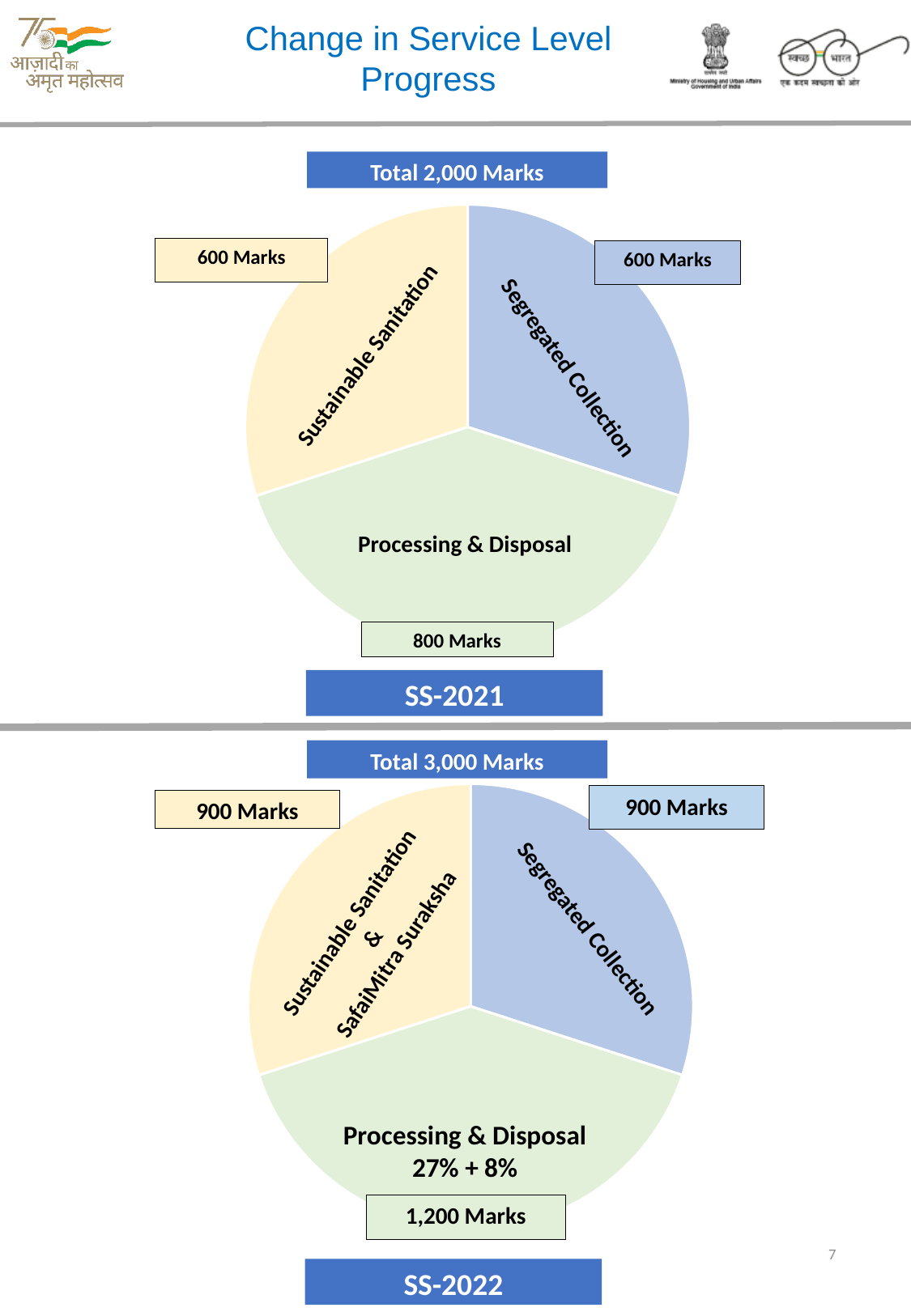
In the SS-2022 chart (bottom), what is the difference in marks between Processing & Disposal and Sustainable Sanitation & SafaiMitra Suraksha? 300 Marks In the SS-2022 chart (bottom), how many marks are allotted to Segregated Collection? 900 Marks How many categories does the SS-2021 chart (top) show? 3 In the SS-2021 chart (top), what is the difference in marks between Processing & Disposal and Segregated Collection? 200 Marks In the SS-2021 chart (top), what share of the total marks does Processing & Disposal represent? 40% In the SS-2021 chart (top), which category has the largest share of marks? Processing & Disposal In the SS-2021 chart (top), how many marks are allotted to Processing & Disposal? 800 Marks In the SS-2022 chart (bottom), how many marks are allotted to Processing & Disposal? 1,200 Marks In the SS-2022 chart (bottom), which category has the largest share of marks? Processing & Disposal What is the total number of marks shown for the SS-2022 chart (bottom)? 3,000 Marks Which is larger: Processing & Disposal marks in SS-2021 (top chart) or Processing & Disposal marks in SS-2022 (bottom chart)? SS-2022 What type of chart is used for SS-2022 (bottom)? Pie chart